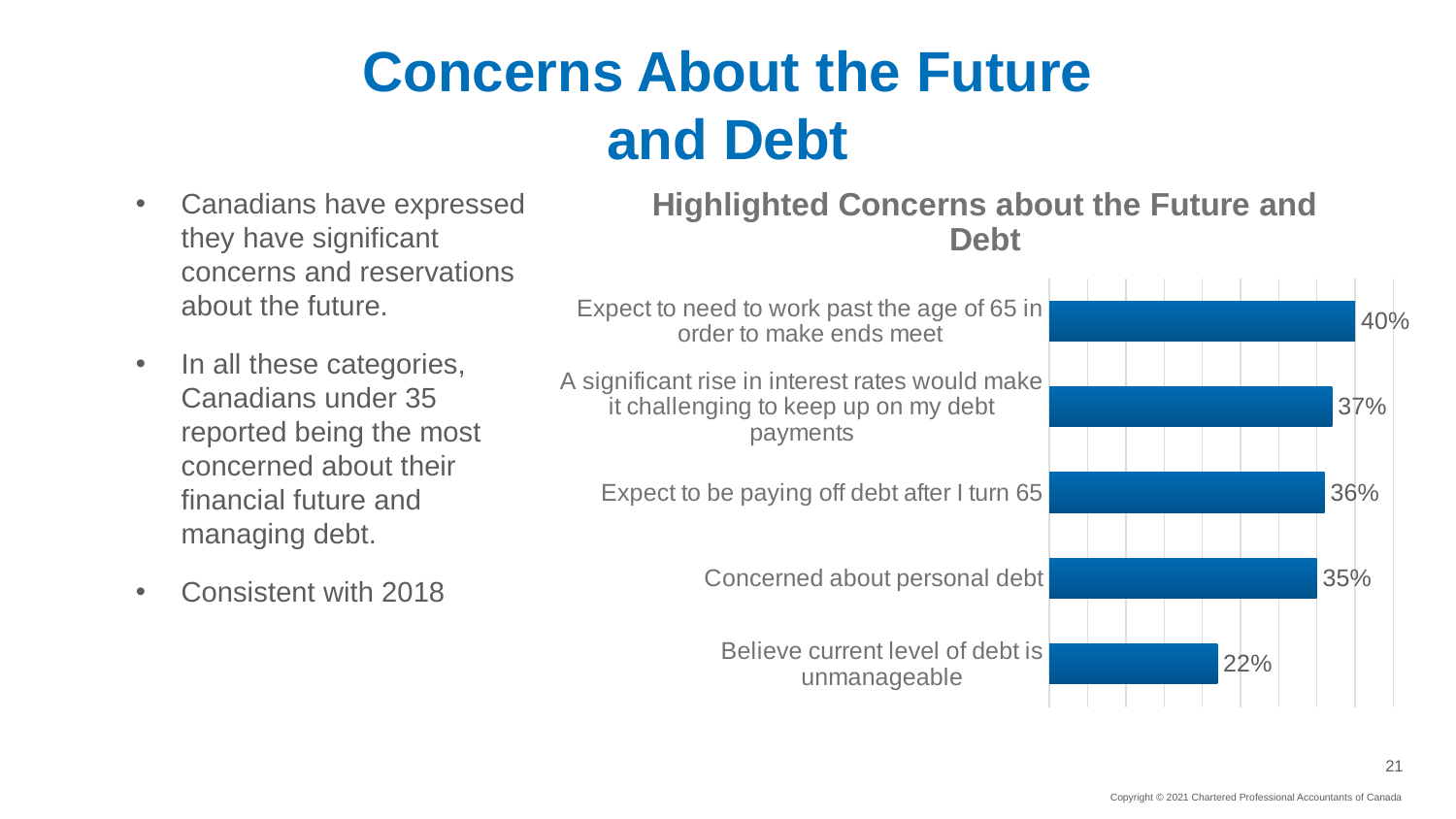
What is the value for 'Expect to be paying off debt after I turn 65'? 36% How much higher is 'A significant rise in interest rates would make it challenging to keep up on my debt payments' than 'Concerned about personal debt'? 2% Which is larger: the value for 'Expect to be paying off debt after I turn 65' or 'Believe current level of debt is unmanageable'? Expect to be paying off debt after I turn 65 How many categories are shown in the chart? 5 What is the difference between the highest and lowest values in the chart? 18% What type of chart is shown on the slide? Bar chart What percentage of respondents expect to need to work past the age of 65 in order to make ends meet? 40% What is the value for 'Believe current level of debt is unmanageable'? 22% What is the title of the chart? Highlighted Concerns about the Future and Debt Which concern has the highest percentage? Expect to need to work past the age of 65 in order to make ends meet Which concern has the lowest percentage? Believe current level of debt is unmanageable What percentage are concerned about personal debt? 35%